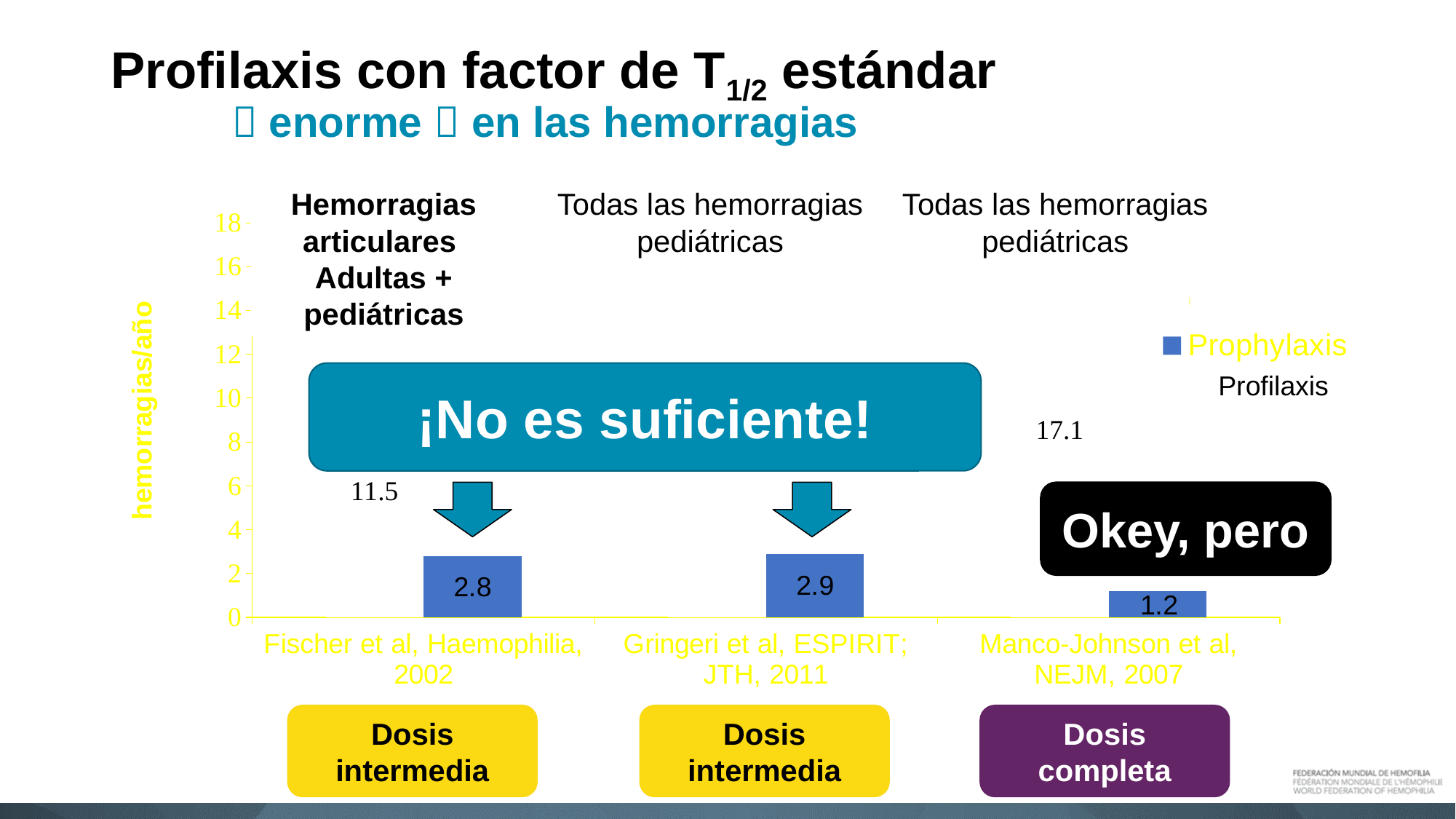
What kind of chart is shown on the slide? bar chart Which study has the lowest Prophylaxis value? Manco-Johnson et al, NEJM, 2007 What is the Prophylaxis value for Manco-Johnson et al, NEJM, 2007? 1.2 What is the difference between the Prophylaxis values for Fischer et al, Haemophilia, 2002 and Manco-Johnson et al, NEJM, 2007? 1.6 Is the Prophylaxis value for Manco-Johnson et al, NEJM, 2007 greater or less than 2? less Which has a larger Prophylaxis value: Fischer et al, Haemophilia, 2002 or Manco-Johnson et al, NEJM, 2007? Fischer et al, Haemophilia, 2002 How many studies are shown on the x axis of the chart? 3 What is the label of the y axis of the chart? hemorragias/año What is the Prophylaxis value for Fischer et al, Haemophilia, 2002? 2.8 What is the Prophylaxis value for Gringeri et al, ESPIRIT; JTH, 2011? 2.9 What is the difference between the Prophylaxis values for Gringeri et al, ESPIRIT; JTH, 2011 and Manco-Johnson et al, NEJM, 2007? 1.7 Which study has the highest Prophylaxis value? Gringeri et al, ESPIRIT; JTH, 2011